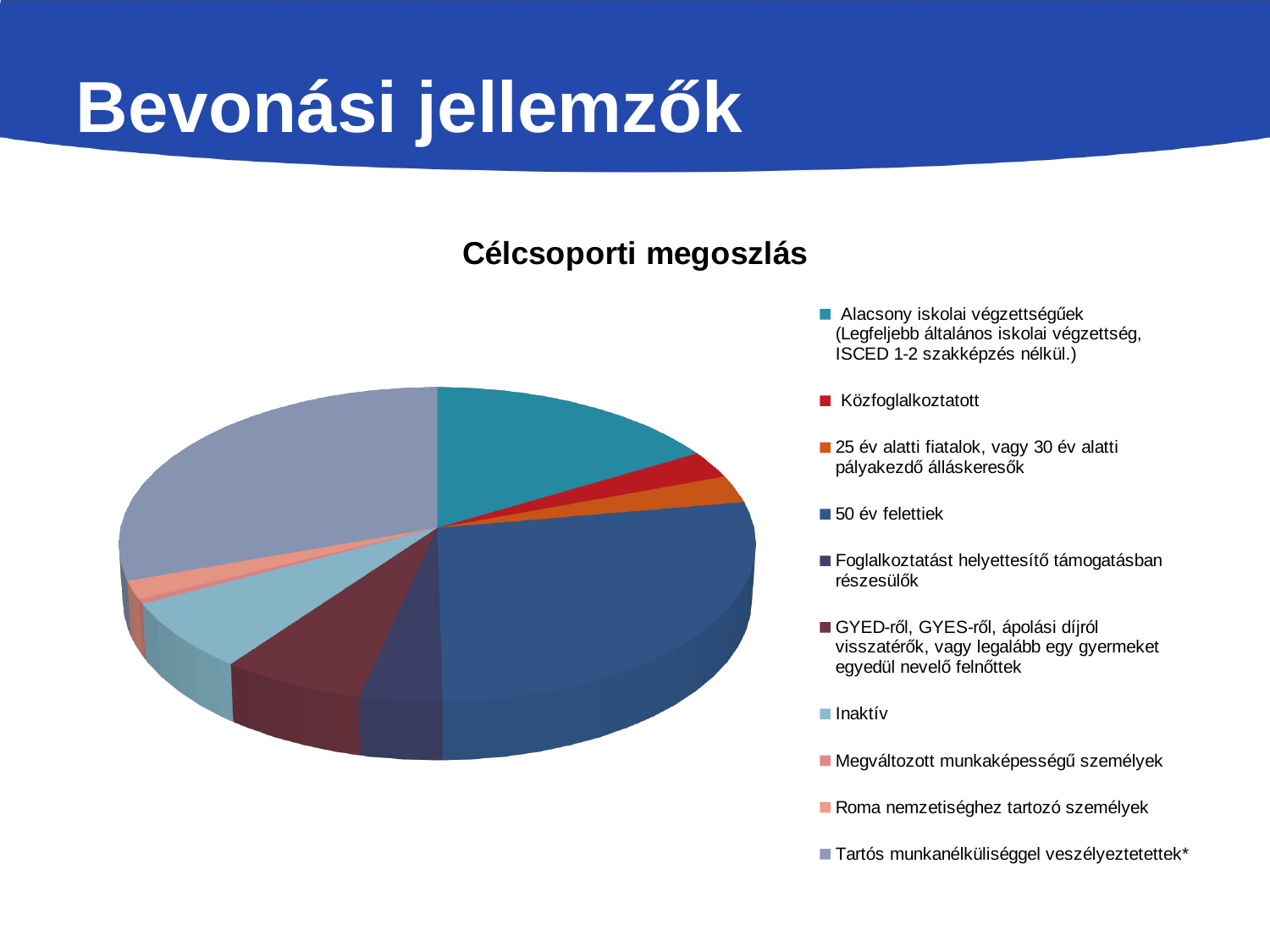
Which category has the second largest slice of the pie? 50 év felettiek Which colour represents the 50 év felettiek category in the pie chart? dark blue Which slice is larger: Alacsony iskolai végzettségűek or Közfoglalkoztatott? Alacsony iskolai végzettségűek Which category has the largest slice of the pie? Tartós munkanélküliséggel veszélyeztetettek* What is the title of the chart? Célcsoporti megoszlás What kind of chart is shown on the slide? pie chart How many categories does the legend of the pie chart list? 10 Which slice is larger: Közfoglalkoztatott or Tartós munkanélküliséggel veszélyeztetettek*? Tartós munkanélküliséggel veszélyeztetettek* Which slice is larger: Inaktív or Roma nemzetiséghez tartozó személyek? Inaktív